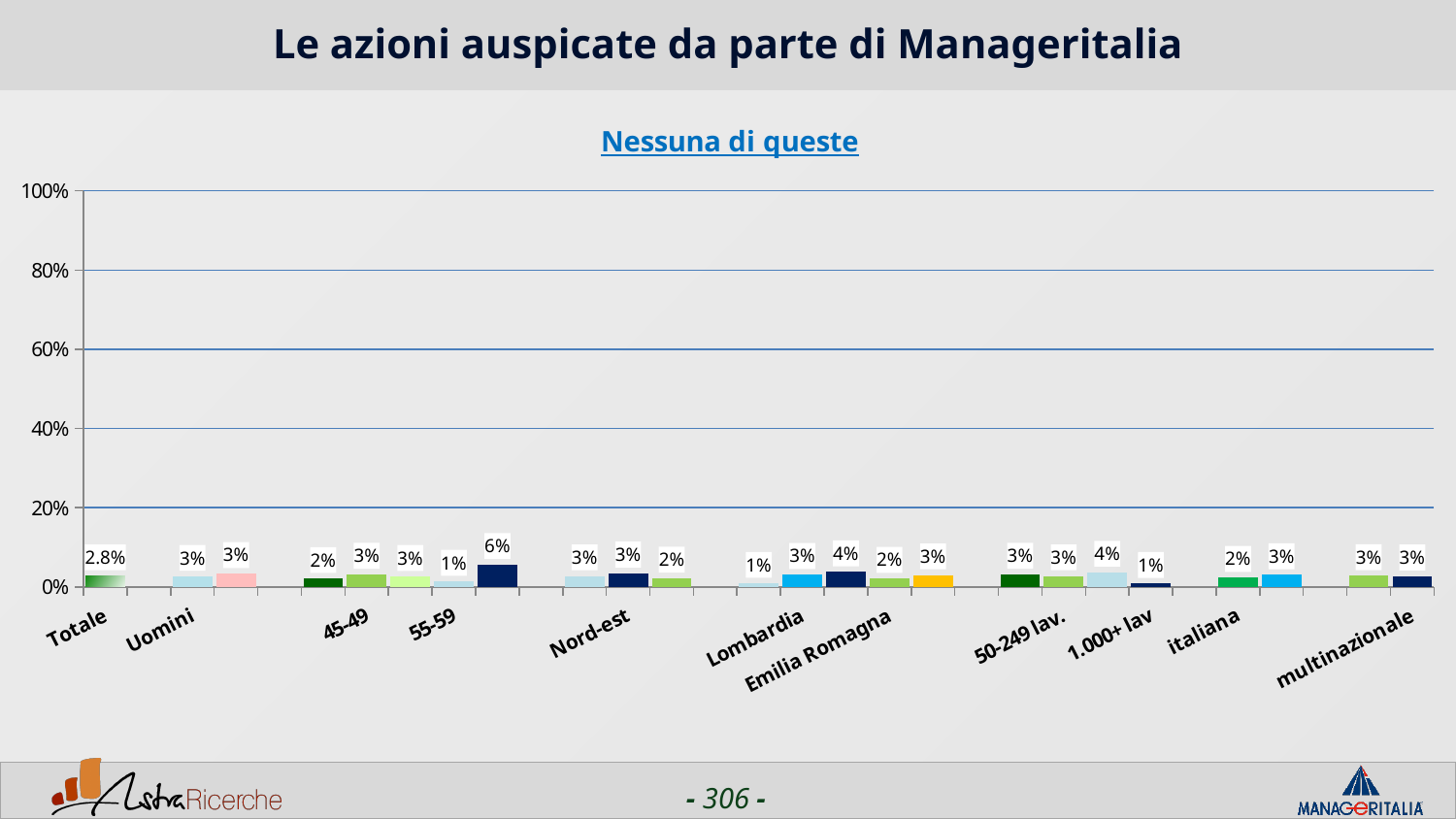
Which is larger, the value for 45-49 or the value for 55-59? 45-49 What is the highest value shown by any bar in the chart? 6% What is the value for 55-59? 1% What is the title of the chart? Nessuna di queste What is the difference between the value for Lombardia and the value for Emilia Romagna? 1% What is the value for multinazionale? 3% Is the value for Totale greater or less than 20%? less What is the value for Totale? 2.8% What type of chart is shown on the slide? bar chart What is the value for Emilia Romagna? 2% What is the value for Uomini? 3% What is the value for 1.000+ lav? 1%